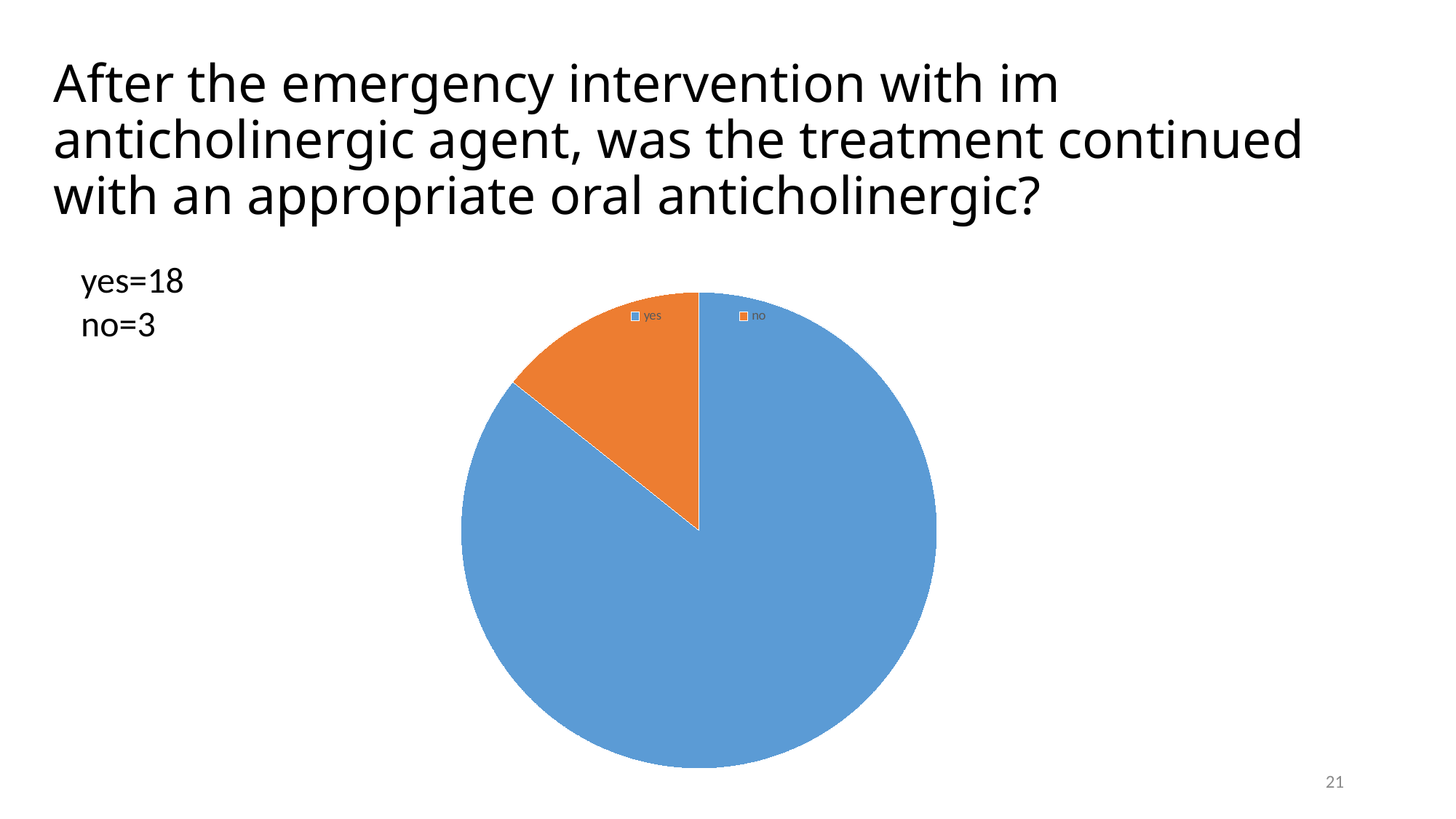
Which is larger, the value for "yes" or the value for "no"? yes How many slices does the pie chart have? 2 What colour is the "no" slice in the pie chart? orange What kind of chart is shown on the slide? pie chart Which category has the smallest slice in the pie chart? no What is the value for "yes" in the pie chart? 18 What is the value for "no" in the pie chart? 3 Which category has the largest slice in the pie chart? yes What is the difference between the "yes" and "no" values? 15 What is the total of the "yes" and "no" values shown on the slide? 21 How many entries does the legend of the pie chart list? 2 What colour is the "yes" slice in the pie chart? blue